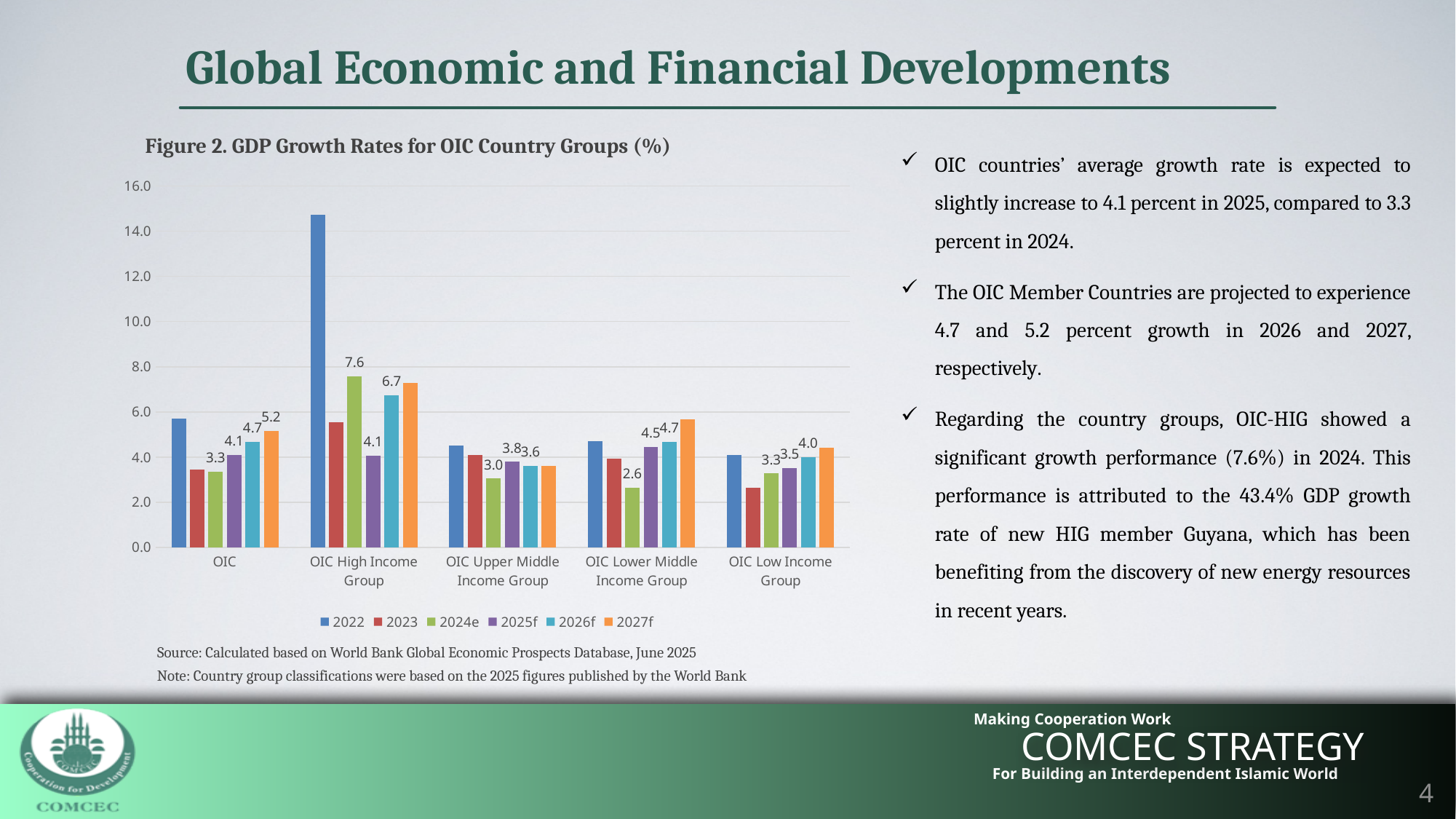
How many country groups are shown on the x axis of the chart? 5 How many series does the legend list? 6 Which has a higher 2026f GDP growth rate: the OIC High Income Group or the OIC Lower Middle Income Group? OIC High Income Group Which country group has the highest 2024e GDP growth rate? OIC High Income Group What is the 2026f GDP growth rate for the OIC group? 4.7 Is the 2022 value for the OIC High Income Group greater or less than 12.0? greater What is the 2027f GDP growth rate for the OIC group? 5.2 What is the difference between the 2027f and 2024e GDP growth rates for the OIC group? 1.9 Which country group has the lowest 2024e GDP growth rate? OIC Lower Middle Income Group What kind of chart is Figure 2? bar chart What is the 2024e GDP growth rate for the OIC High Income Group? 7.6 What is the 2025f GDP growth rate for the OIC Lower Middle Income Group? 4.5